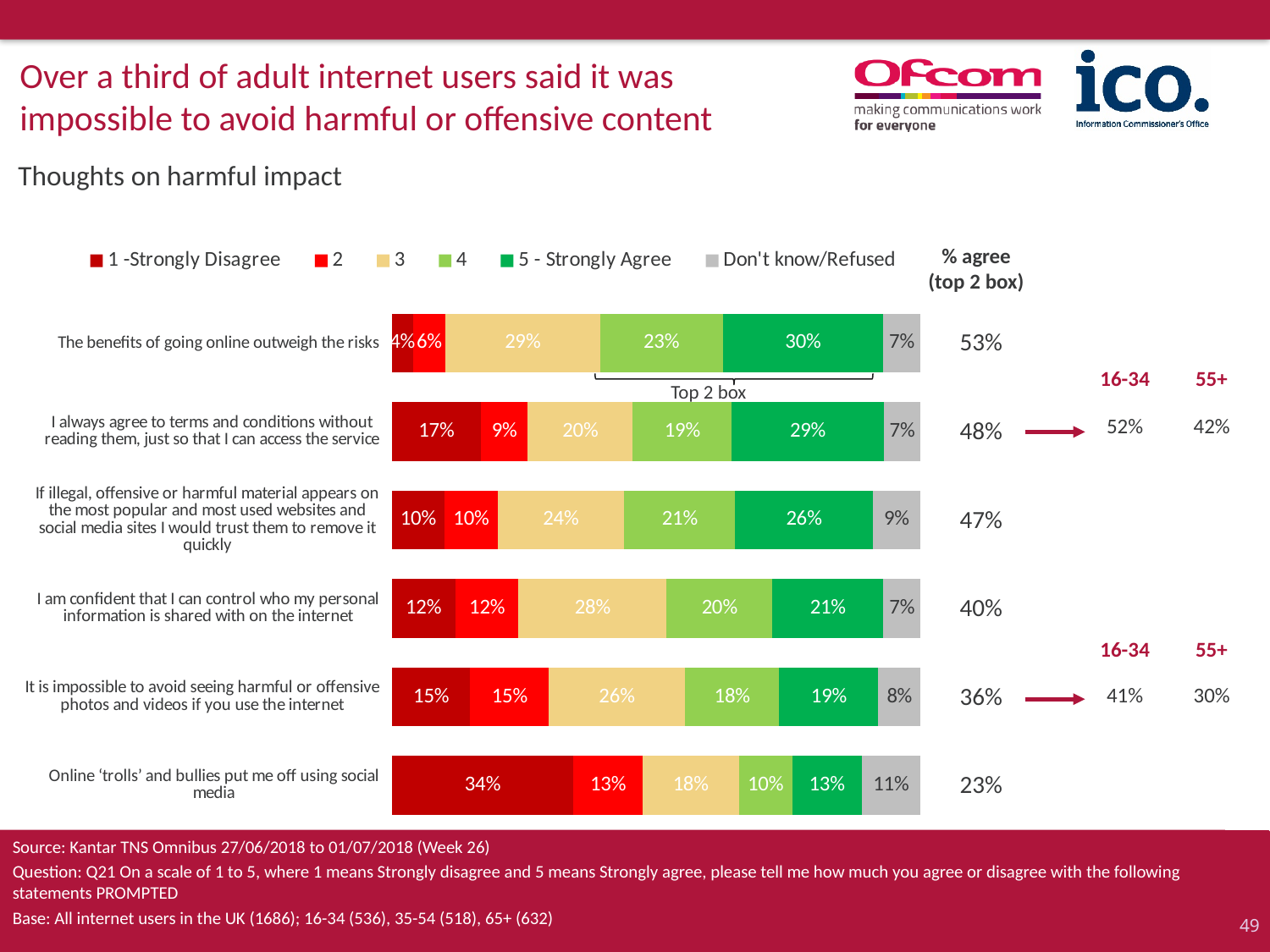
What is the '% agree (top 2 box)' value for 'It is impossible to avoid seeing harmful or offensive photos and videos if you use the internet'? 36% Which statement has the highest '% agree (top 2 box)' value? The benefits of going online outweigh the risks What percentage of respondents answered '5 - Strongly Agree' to 'The benefits of going online outweigh the risks'? 30% What is the 'Don't know/Refused' percentage for 'If illegal, offensive or harmful material appears on the most popular and most used websites and social media sites I would trust them to remove it quickly'? 9% What is the difference between the '% agree (top 2 box)' values for 16-34 and 55+ for 'I always agree to terms and conditions without reading them'? 10% What is the combined percentage of '4' and '5 - Strongly Agree' responses for 'Online 'trolls' and bullies put me off using social media'? 23% What kind of chart is shown on the slide? Stacked bar chart Which is larger for 'I am confident that I can control who my personal information is shared with on the internet': the share answering '3' or the share answering '5 - Strongly Agree'? 3 What percentage answered '1 - Strongly Disagree' to 'Online 'trolls' and bullies put me off using social media'? 34% How many series does the legend list? 6 How many statements are plotted in the chart? 6 Which statement has the lowest '% agree (top 2 box)' value? Online 'trolls' and bullies put me off using social media